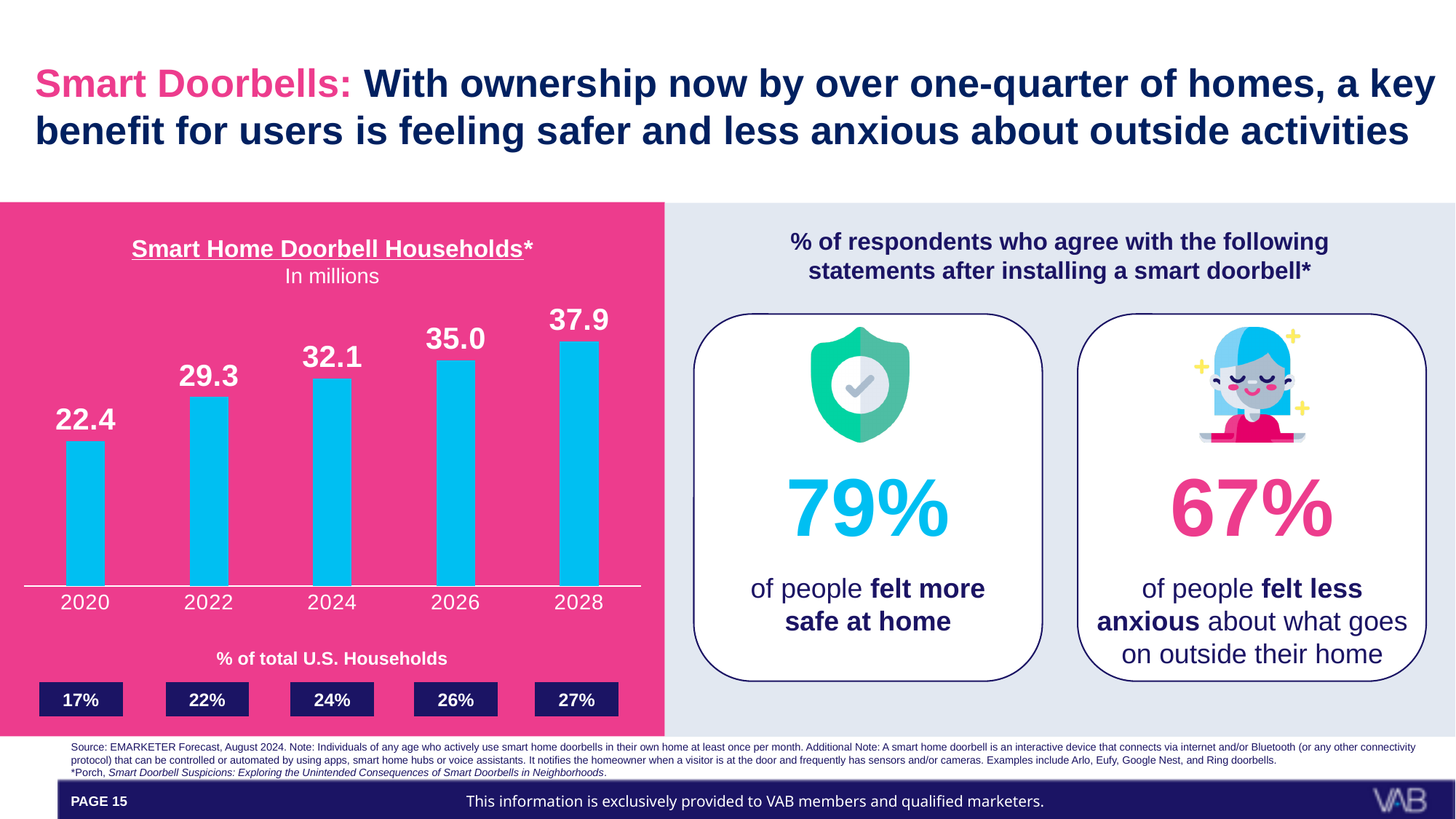
In the Smart Home Doorbell Households chart, what is the difference between the 2026 and 2022 values? 5.7 In the Smart Home Doorbell Households chart, what is the difference between the 2028 and 2020 values? 15.5 In the Smart Home Doorbell Households chart, what is the value for 2028? 37.9 What kind of chart is the Smart Home Doorbell Households chart? Bar chart How many years are shown in the Smart Home Doorbell Households chart? 5 In the Smart Home Doorbell Households chart, do the values rise or fall from 2020 to 2028? Rise In the Smart Home Doorbell Households chart, which is larger, the value for 2022 or the value for 2026? 2026 In the Smart Home Doorbell Households chart, which year has the highest value? 2028 In the Smart Home Doorbell Households chart, what is the value for 2020? 22.4 In the Smart Home Doorbell Households chart, what is the value for 2024? 32.1 In the Smart Home Doorbell Households chart, what unit are the values shown in? In millions In the Smart Home Doorbell Households chart, which year has the lowest value? 2020